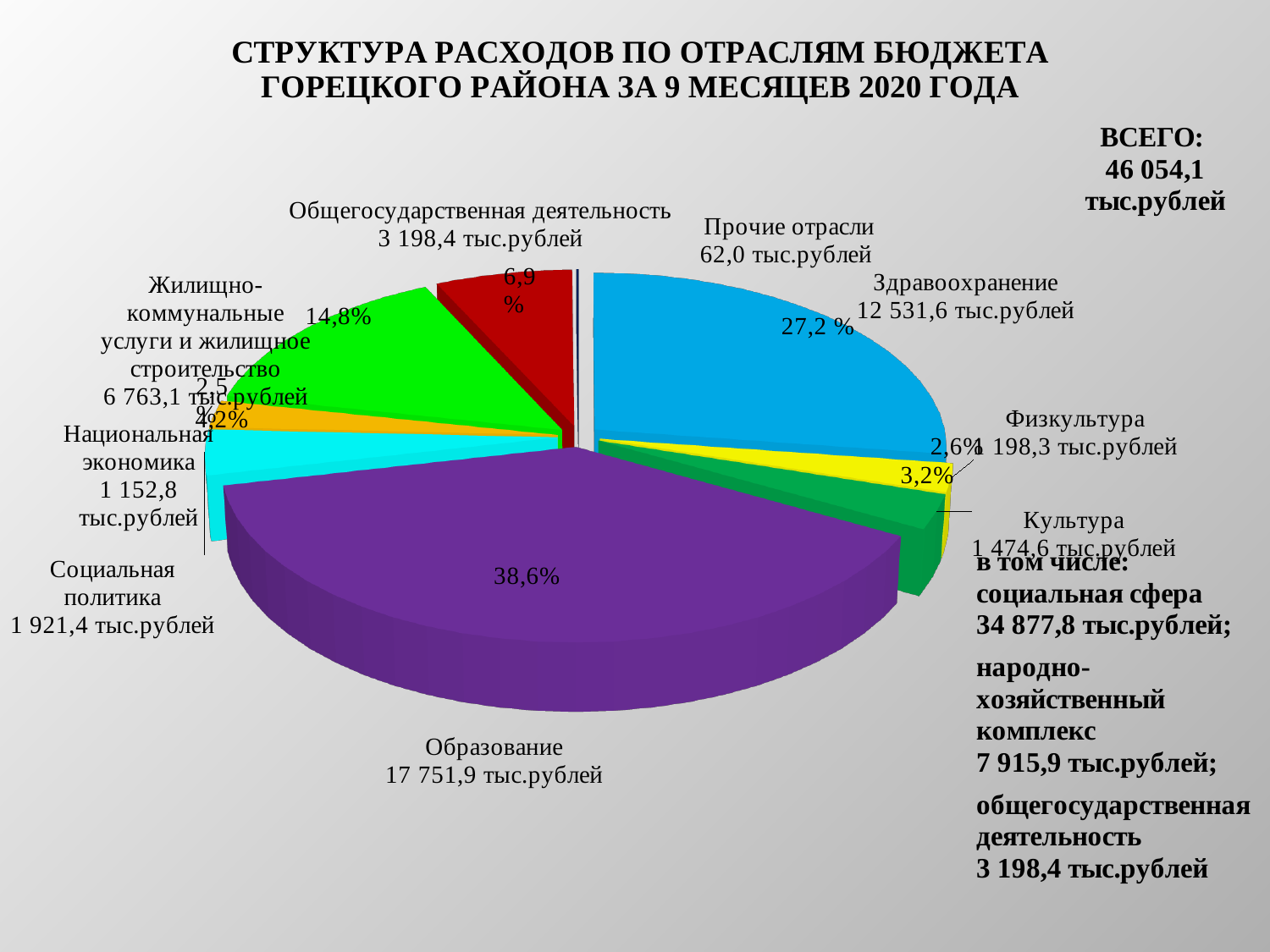
What share of the pie does Образование account for? 38,6% What is the expenditure value for Образование? 17 751,9 тыс.рублей What is the difference between the expenditure for Образование and Здравоохранение? 5 220,3 тыс.рублей What kind of chart is shown on the slide? pie chart What is the expenditure value for Здравоохранение? 12 531,6 тыс.рублей What share of the pie does Здравоохранение account for? 27,2 % How many sectors (slices) does the pie chart show? 9 What is the total expenditure (ВСЕГО) shown on the slide? 46 054,1 тыс.рублей What is the expenditure value for Жилищно-коммунальные услуги и жилищное строительство? 6 763,1 тыс.рублей Which sector has the largest share of expenditure? Образование Which sector has the smallest expenditure? Прочие отрасли What is the expenditure value for Культура? 1 474,6 тыс.рублей